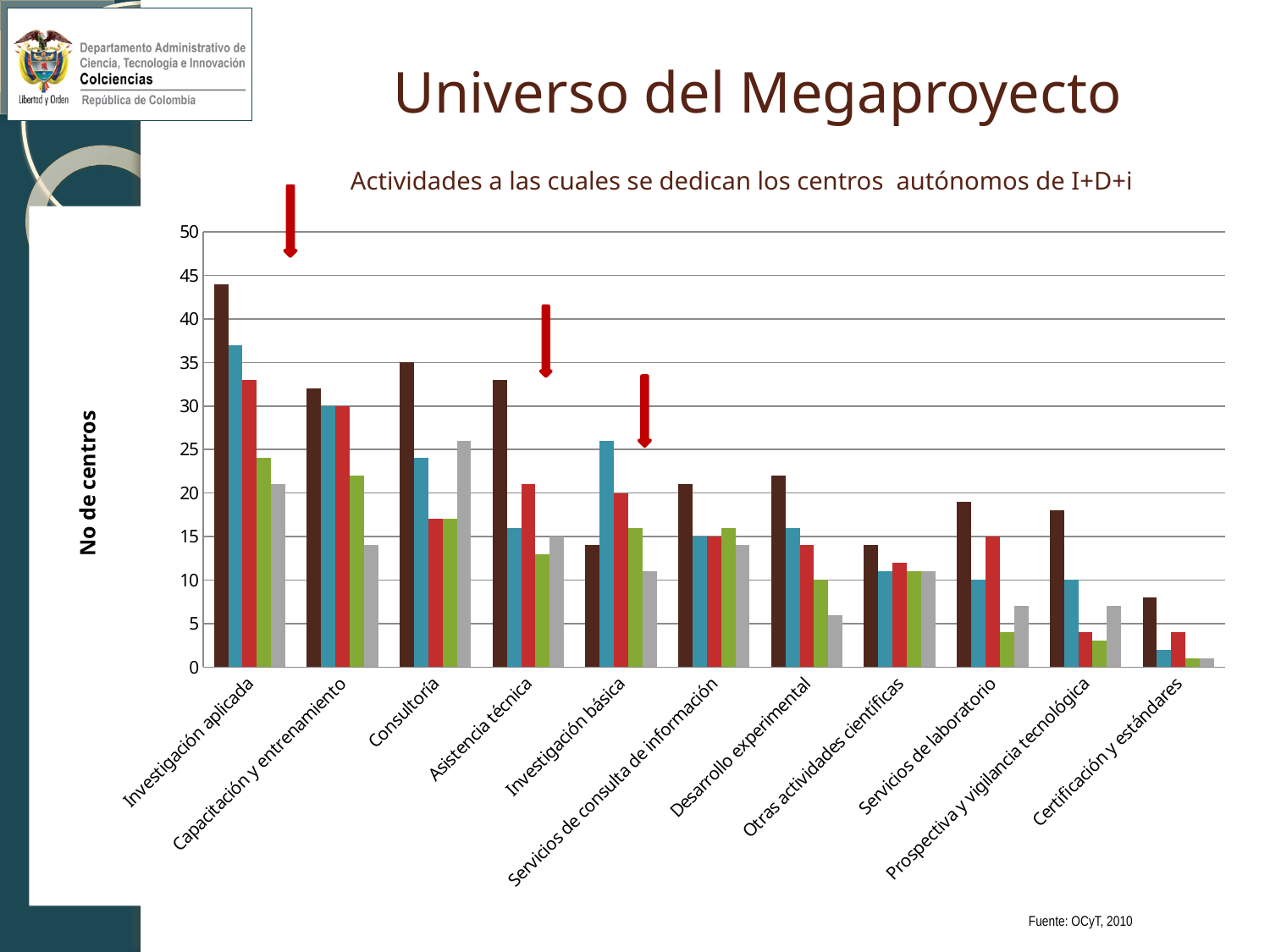
Is the teal bar for Investigación básica greater or less than 20? greater How many activity categories are shown on the x axis of the chart? 11 Which has the taller dark brown bar, Investigación aplicada or Consultoría? Investigación aplicada Do the dark brown bars generally rise or fall from left to right across the categories? fall What is the label on the vertical axis of the chart? No de centros Is the dark brown bar for Certificación y estándares greater or less than 10? less How many bars are plotted for each category in the chart? 5 Is the dark brown bar for Prospectiva y vigilancia tecnológica greater or less than 15? greater What kind of chart is shown on the slide? bar chart Which category has the shortest dark brown bar? Certificación y estándares Which category has the tallest dark brown bar? Investigación aplicada